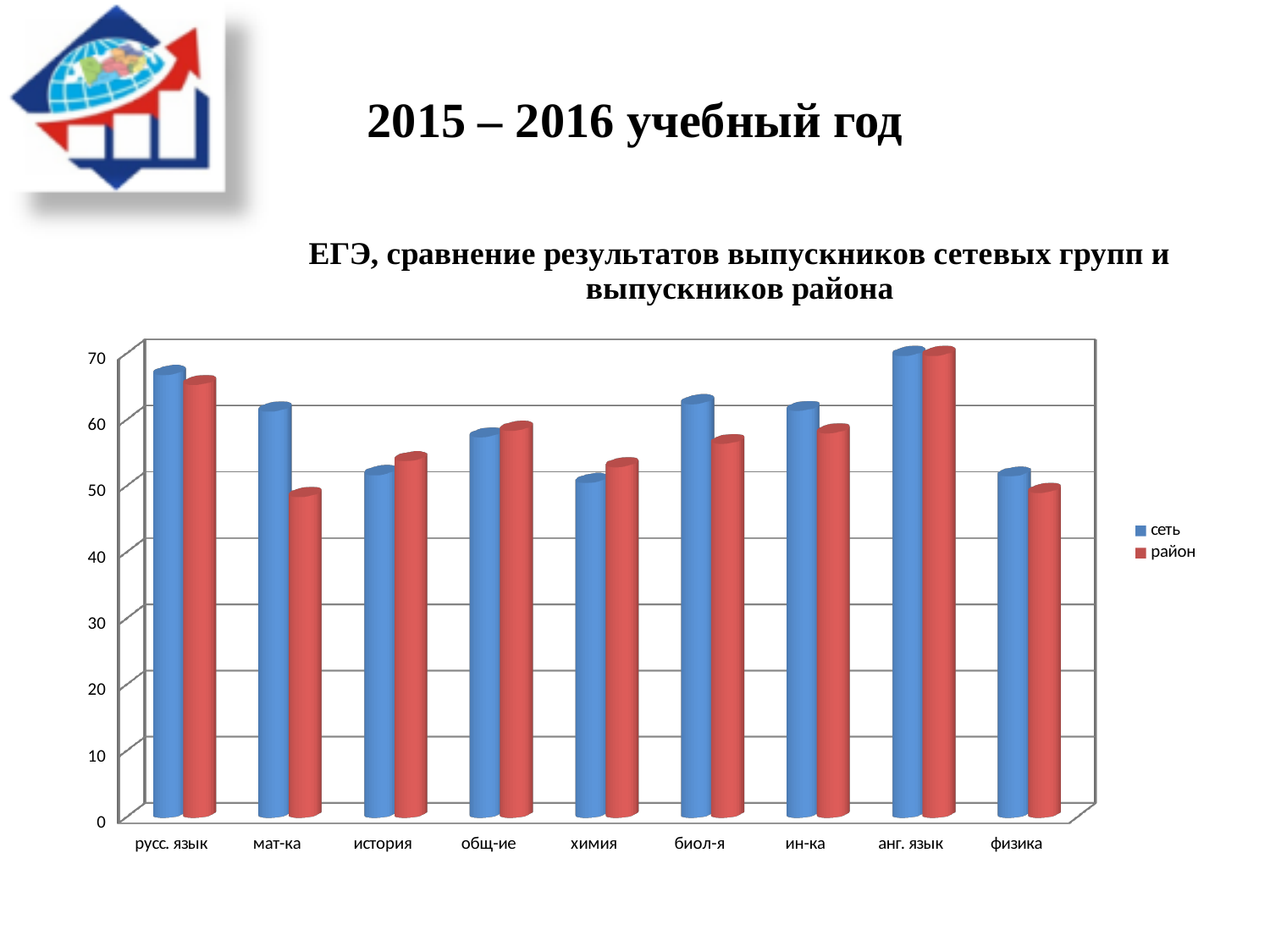
Is the value for сеть in русс. язык greater or less than 60? greater Which colour represents the район series in the chart? red Is the value for район in биол-я greater or less than 50? greater What is the title of the chart? ЕГЭ, сравнение результатов выпускников сетевых групп и выпускников района Is the value for район in мат-ка greater or less than 50? less For биол-я, which series has the larger value, сеть or район? сеть Which subject has the highest value for the сеть series? анг. язык What kind of chart is shown on the slide? bar chart How many series does the chart legend list? 2 How many subject categories are shown on the x axis of the chart? 9 For мат-ка, which series has the larger value, сеть or район? сеть Which subject has the highest value for the район series? анг. язык